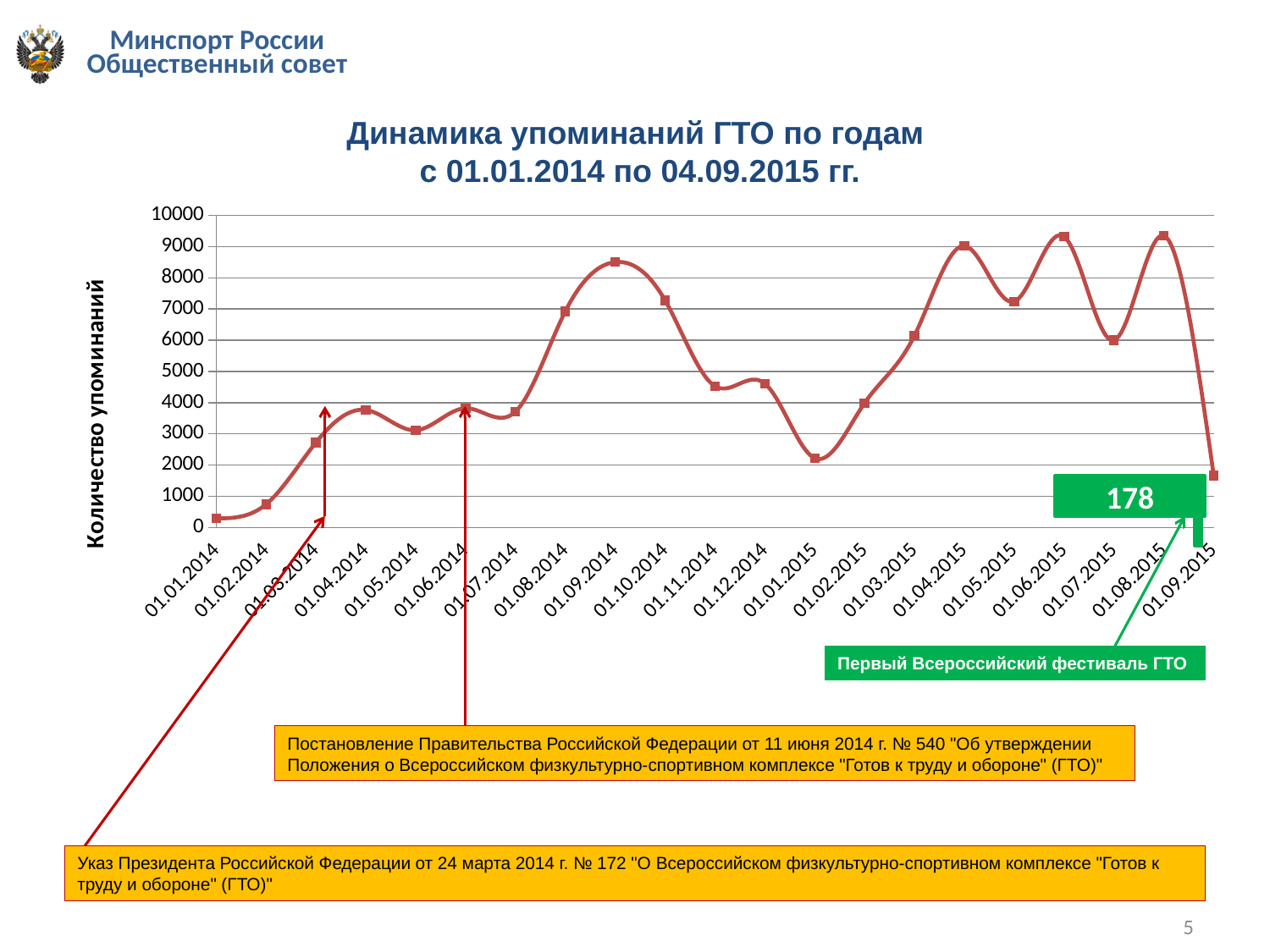
Which date has the lowest number of mentions? 01.01.2014 Is the value for 01.09.2015 greater or less than 2000? less Which has more mentions, 01.09.2014 or 01.10.2014? 01.09.2014 Is the value for 01.01.2014 greater or less than 1000? less Is the value for 01.06.2015 greater or less than 9000? greater What kind of chart is shown on the slide? line chart What is the label of the vertical axis? Количество упоминаний Do the values rise or fall from 01.01.2015 to 01.04.2015? rise How many dates are plotted along the x axis? 21 Which has more mentions, 01.02.2014 or 01.03.2014? 01.03.2014 What is the title of the chart? Динамика упоминаний ГТО по годам с 01.01.2014 по 04.09.2015 гг.